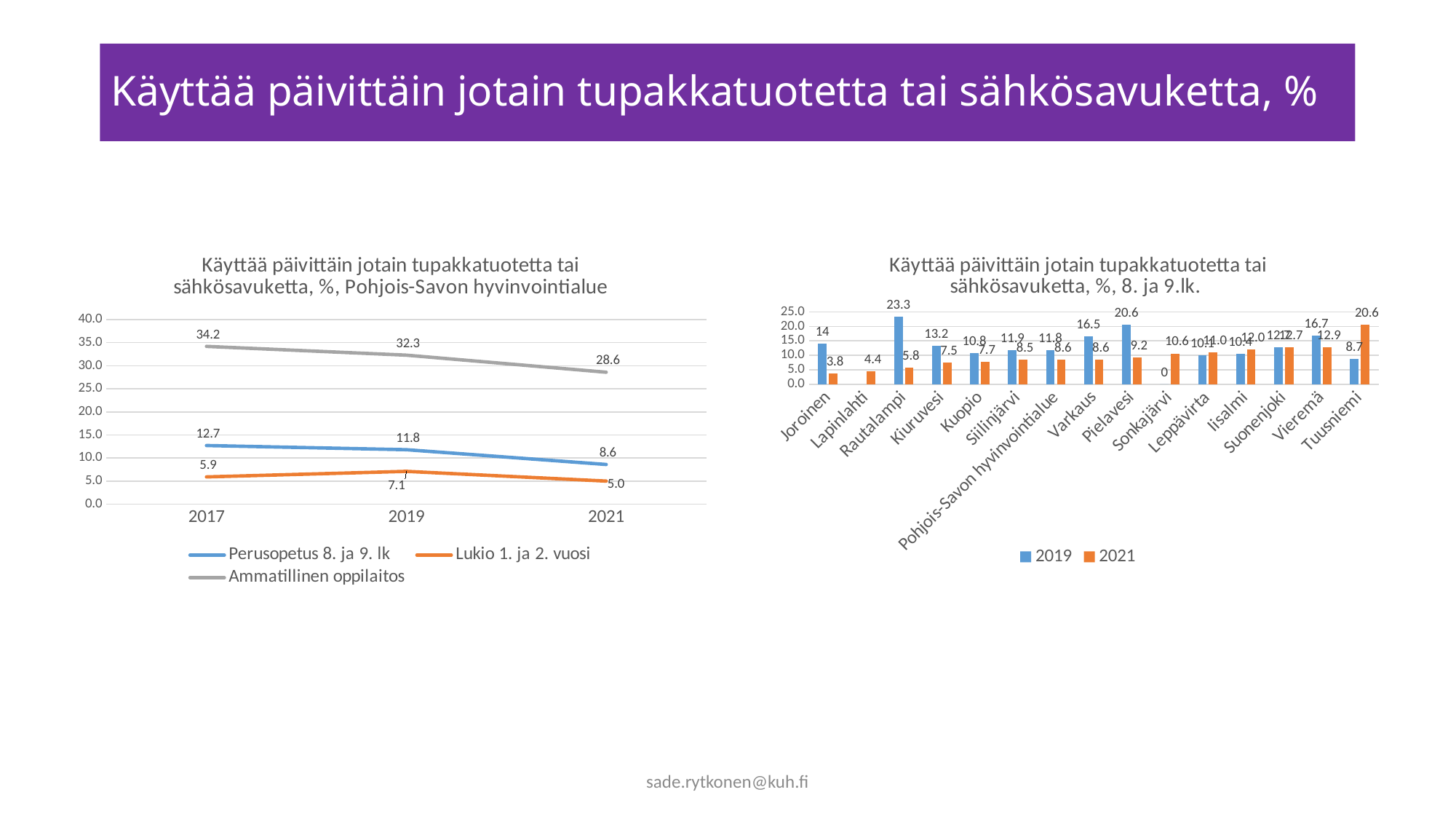
On the right chart (8. ja 9.lk), what is the 2021 value for Tuusniemi? 20.6 On the right chart (8. ja 9.lk), how many categories are shown on the x axis? 15 On the left chart (Pohjois-Savon hyvinvointialue), what is the value for Lukio 1. ja 2. vuosi in 2019? 7.1 On the right chart (8. ja 9.lk), what is the 2019 value for Rautalampi? 23.3 On the left chart (Pohjois-Savon hyvinvointialue), does the Perusopetus 8. ja 9. lk series rise or fall from 2017 to 2021? fall On the left chart (Pohjois-Savon hyvinvointialue), what is the difference between the Ammatillinen oppilaitos values in 2017 and 2021? 5.6 What kind of chart is the left chart (Pohjois-Savon hyvinvointialue)? line chart On the right chart (8. ja 9.lk), which municipality has the highest 2019 value? Rautalampi On the left chart (Pohjois-Savon hyvinvointialue), what is the value for Ammatillinen oppilaitos in 2017? 34.2 On the left chart (Pohjois-Savon hyvinvointialue), how many series does the legend list? 3 On the right chart (8. ja 9.lk), which is larger for Pielavesi: the 2019 value or the 2021 value? 2019 On the right chart (8. ja 9.lk), which category has the lowest 2021 value? Joroinen